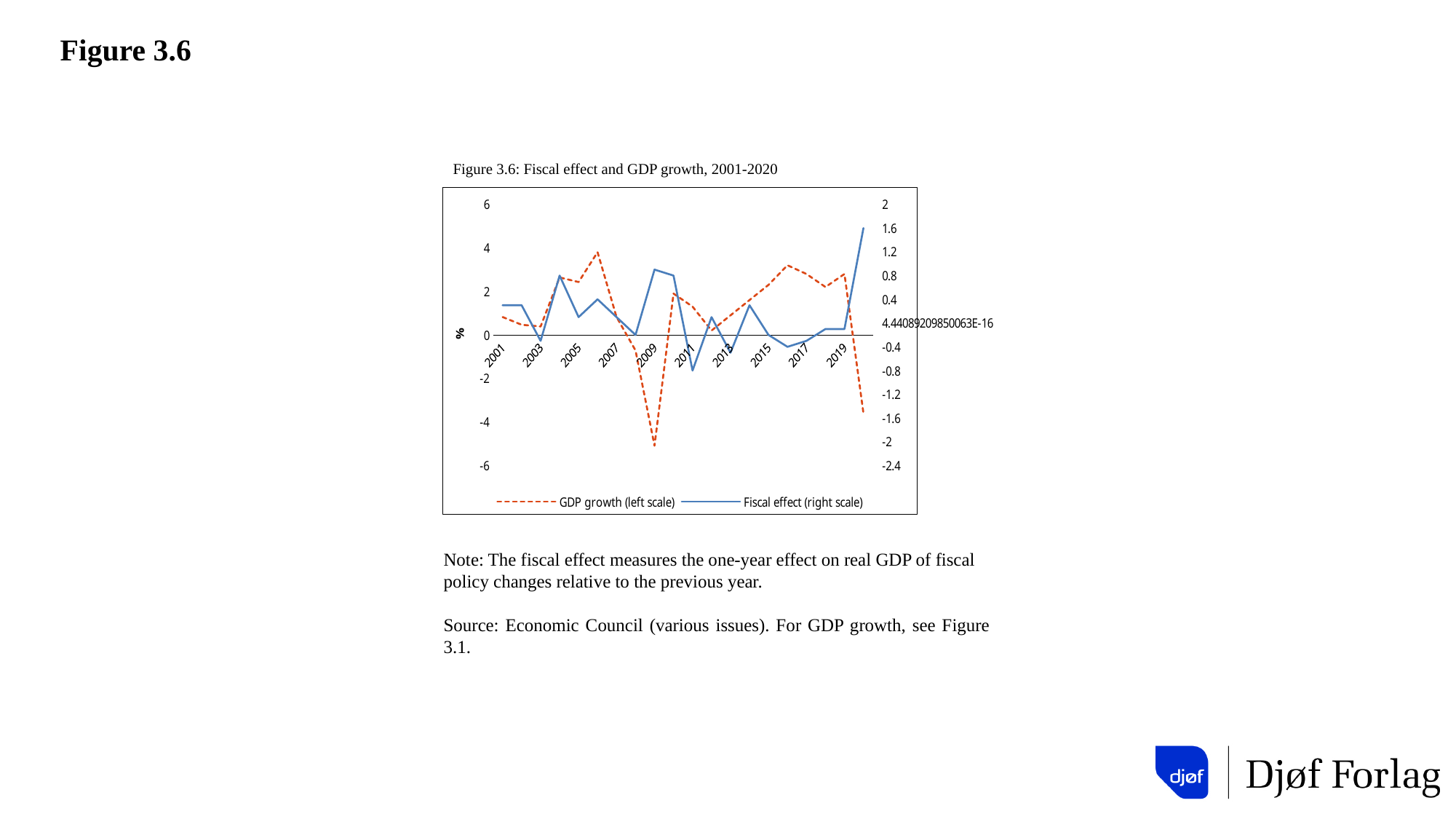
In which year is GDP growth at its lowest? 2009 How many series does the legend list? 2 Is the value for the fiscal effect in 2020 greater or less than 1.2? greater Is the value for GDP growth in 2006 greater or less than 2? greater In which year is the fiscal effect at its lowest? 2011 Which series is plotted on the right scale? Fiscal effect Is the value for GDP growth in 2009 greater or less than -4? less What type of chart is shown on the slide? Line chart In which year is the fiscal effect at its highest? 2020 Which is larger, GDP growth in 2006 or GDP growth in 2009? 2006 What is the title of the chart? Figure 3.6: Fiscal effect and GDP growth, 2001-2020 Does GDP growth rise or fall from 2006 to 2009? Fall